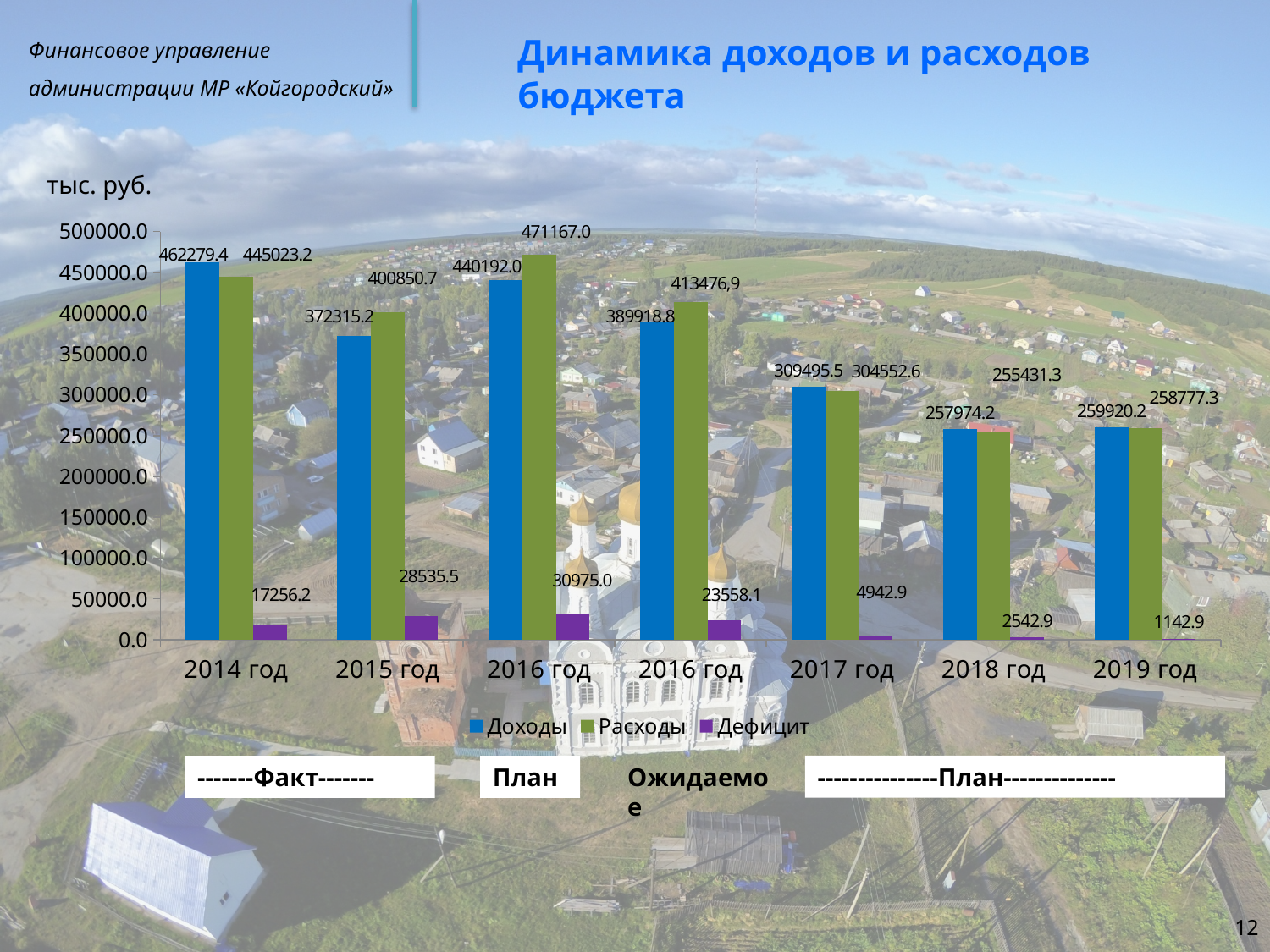
In which year is Расходы the highest? 2016 год (the first one, План) What is the difference between Доходы and Расходы for 2014 год? 17256.2 How many series does the legend list? 3 What is the value of Дефицит for 2019 год? 1142.9 What is the value of Доходы for 2014 год? 462279.4 What is the value of Расходы for 2015 год? 400850.7 What is the value of Дефицит for 2017 год? 4942.9 Is the value of Дефицит for 2015 год greater or less than 50000.0? less What type of chart is shown on the slide? bar chart In which year is Доходы the highest? 2014 год Which is larger for 2015 год, Доходы or Расходы? Расходы How many categories are shown on the x axis? 7